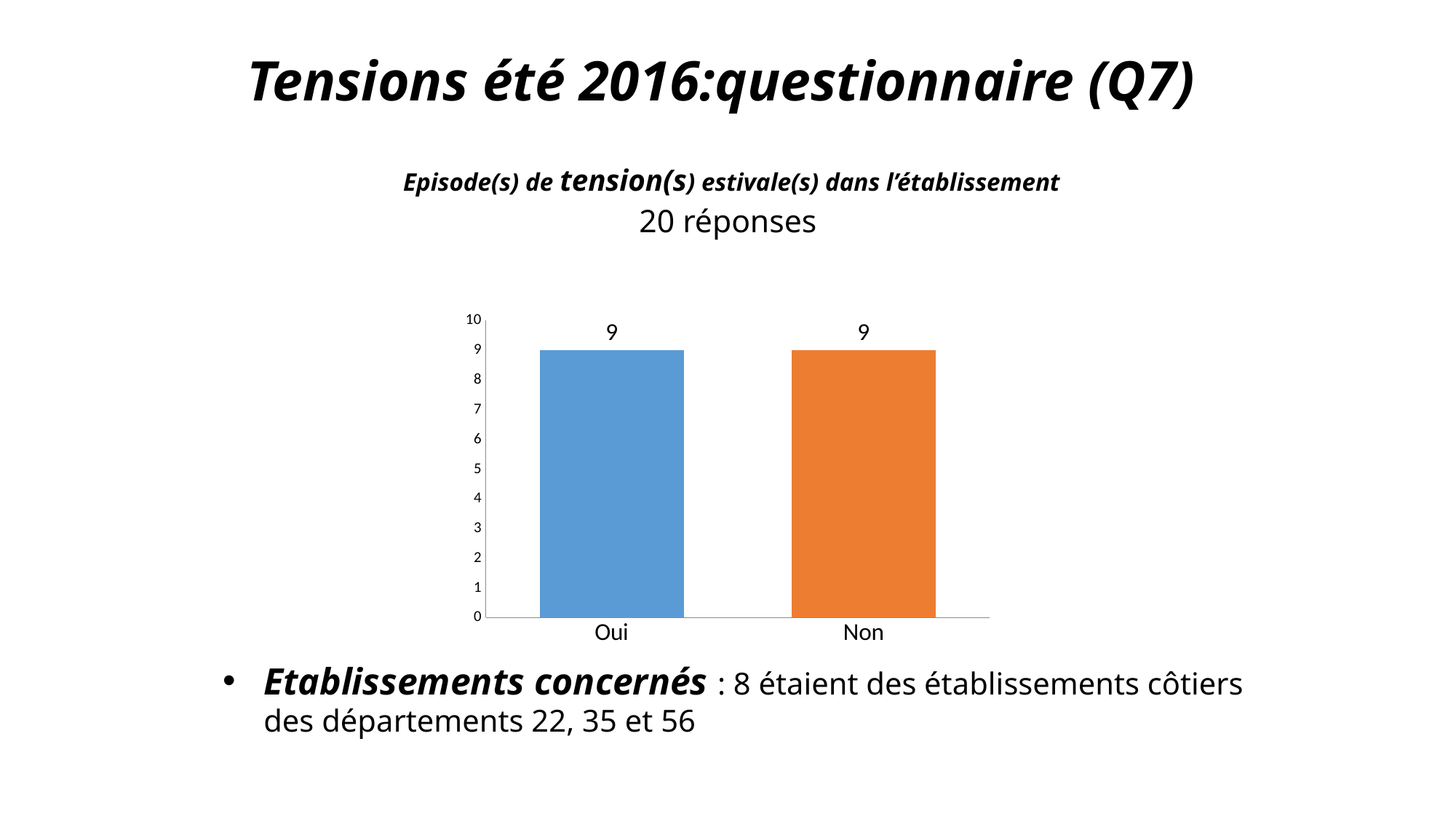
What is the value for Non? 9 Is the value for Non greater or less than 5? greater Is the value for Oui larger than, smaller than, or equal to the value for Non? equal What kind of chart is shown on the slide? bar chart How many categories are shown on the x axis? 2 What colour is the bar for Non? orange What is the difference between the values for Oui and Non? 0 Is the value for Oui greater or less than 10? less What is the value for Oui? 9 What is the highest value shown on the y axis? 10